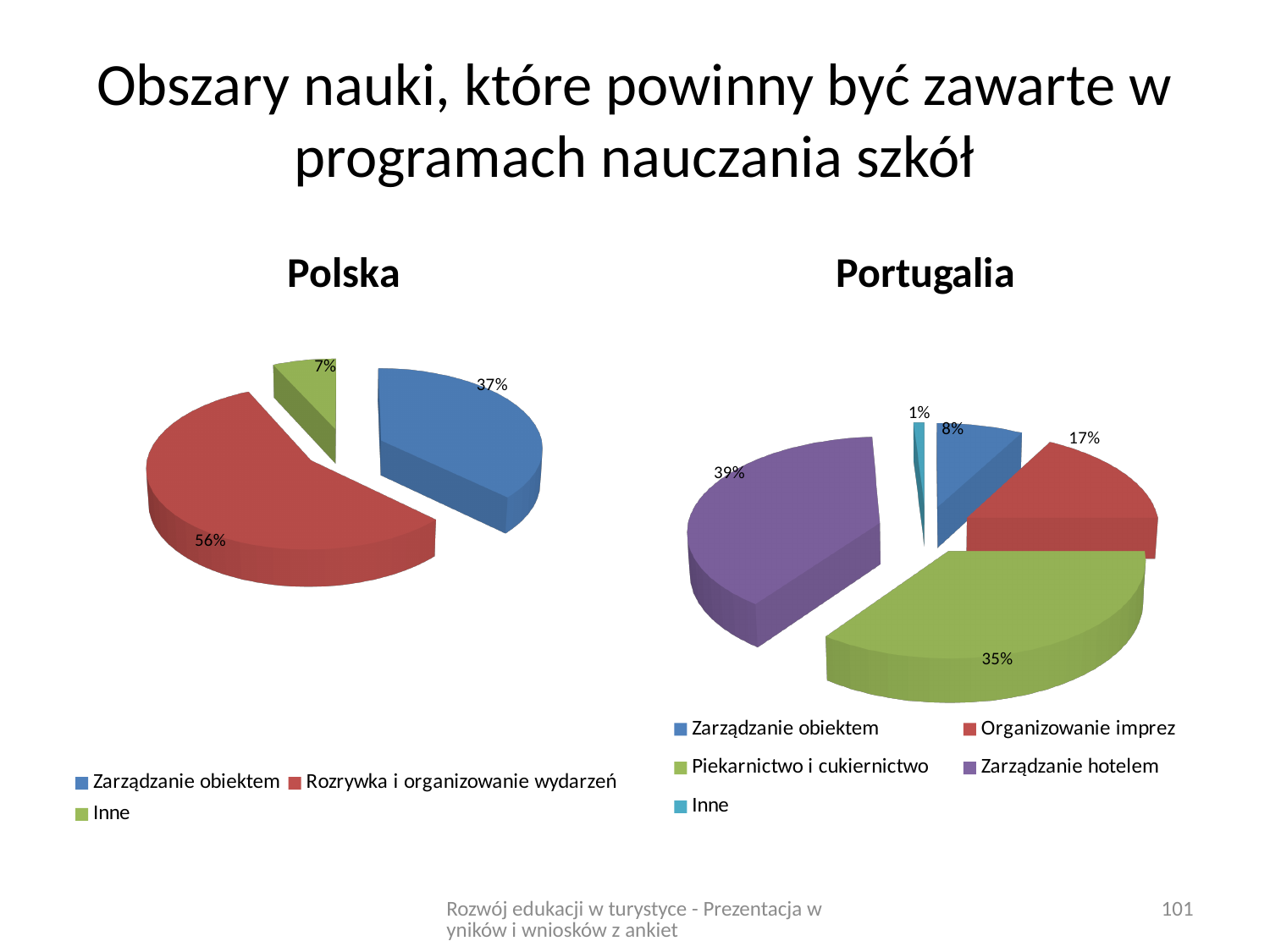
In the Polska chart, which category has the smallest slice? Inne What type of chart is used for the Polska data? Pie chart In the Polska chart, what is the difference between the shares of Rozrywka i organizowanie wydarzeń and Zarządzanie obiektem? 19 percentage points In the Polska chart, what share does Zarządzanie obiektem have? 37% In the Polska chart, how many slices does the pie have? 3 In the Portugalia chart, which category has the smallest slice? Inne In the Portugalia chart, how many categories does the legend list? 5 In the Portugalia chart, what share does Piekarnictwo i cukiernictwo have? 35% In the Polska chart, what share does Rozrywka i organizowanie wydarzeń have? 56% In the Portugalia chart, which is larger: Zarządzanie obiektem or Organizowanie imprez? Organizowanie imprez In the Portugalia chart, which category has the largest slice? Zarządzanie hotelem